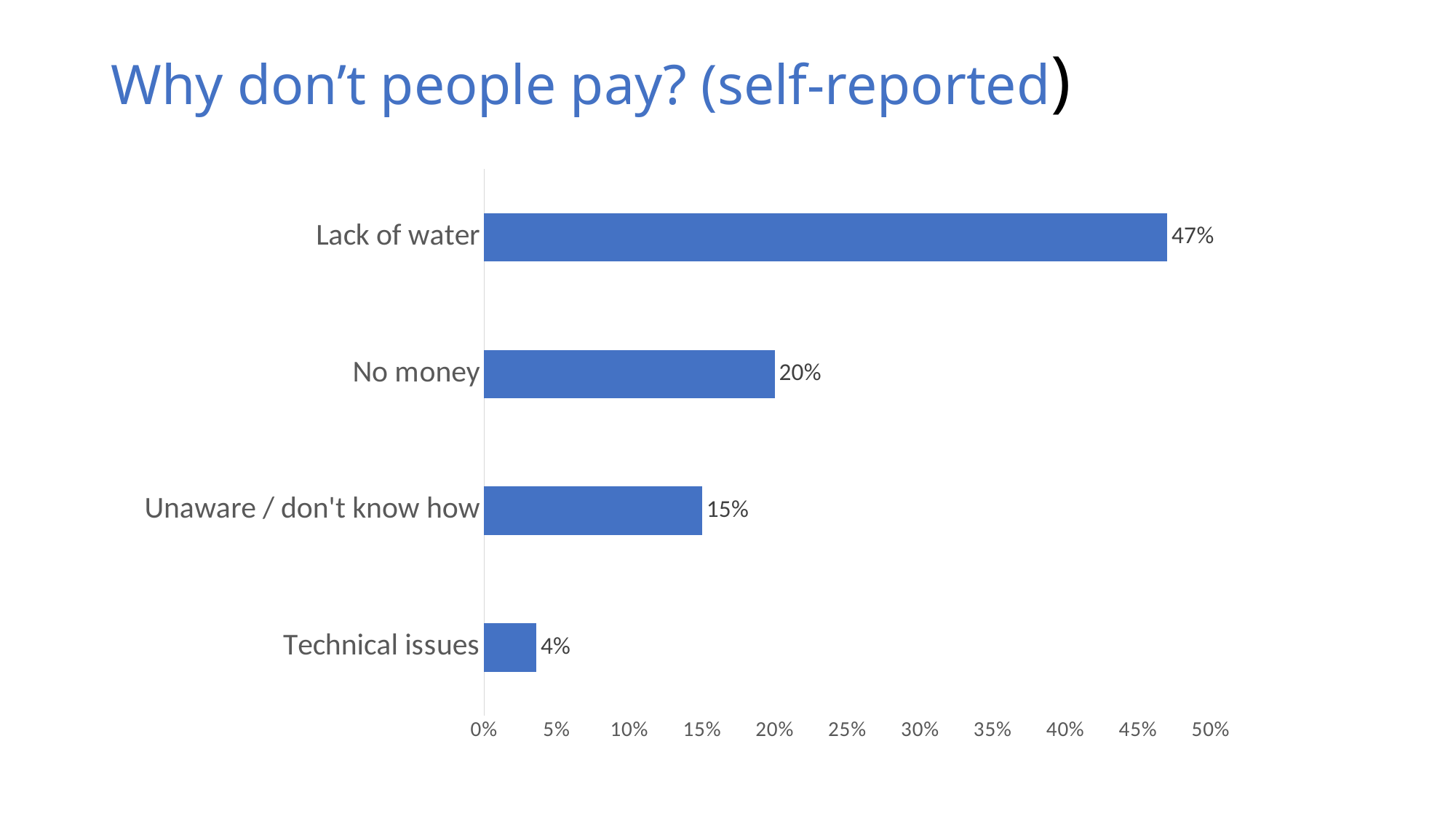
What type of chart is shown on the slide? Bar chart What is the title of the slide? Why don't people pay? (self-reported) Which is larger, the value for 'No money' or the value for 'Technical issues'? No money How many reasons (categories) are shown in the chart? 4 What is the difference in percentage points between 'Lack of water' and 'No money'? 27 percentage points Which reason has the lowest percentage? Technical issues What is the difference between 'No money' and 'Unaware / don't know how'? 5 percentage points What percentage of respondents cited 'Lack of water' as the reason they don't pay? 47% What is the value shown for 'No money'? 20% What is the value for 'Technical issues'? 4% Which reason has the highest percentage? Lack of water What percentage is shown for 'Unaware / don't know how'? 15%